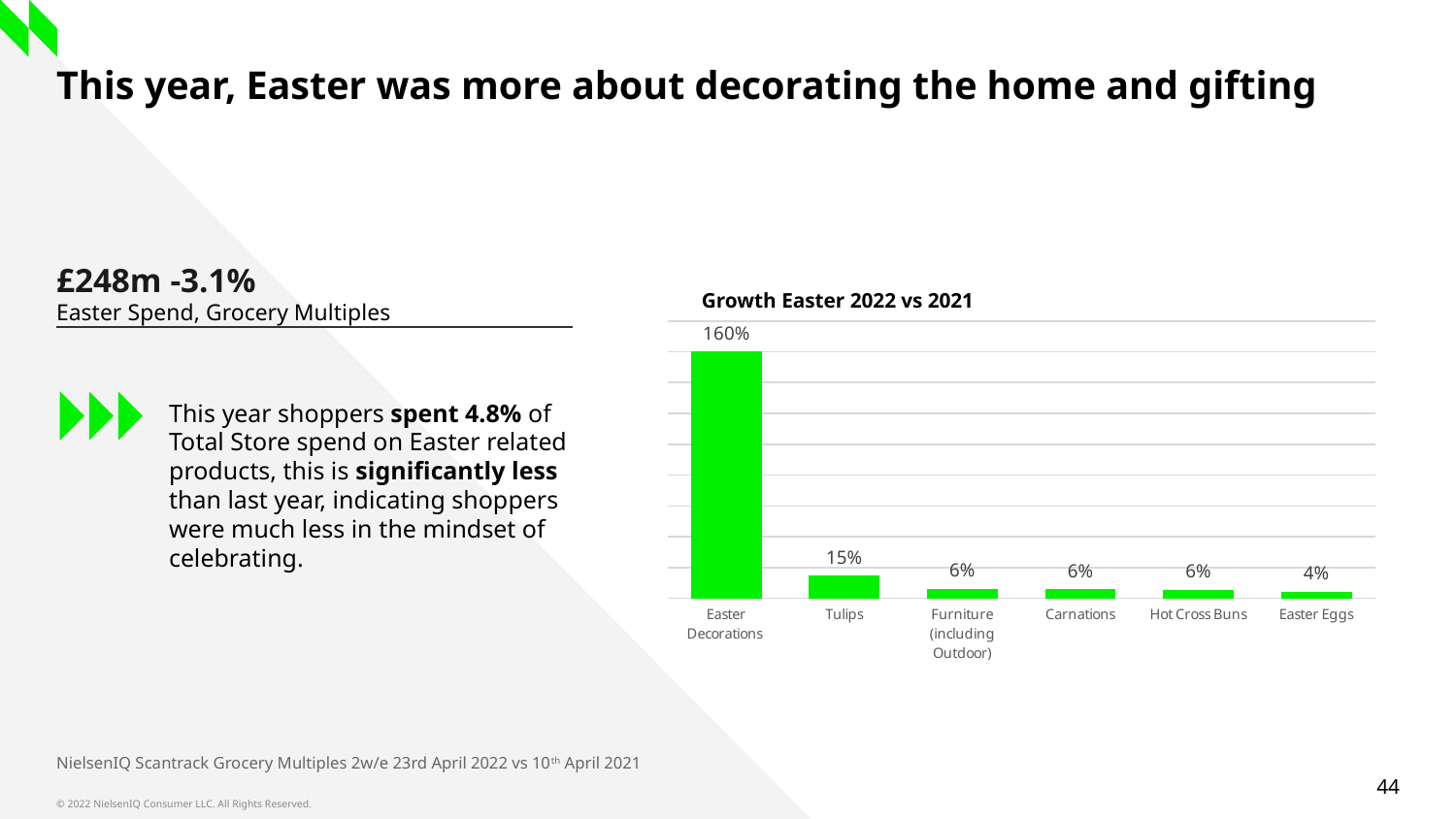
Which category has the highest growth? Easter Decorations Which has higher growth, Tulips or Carnations? Tulips What is the growth value for Easter Eggs? 4% What is the growth value for Easter Decorations? 160% What is the difference between the growth for Easter Decorations and Tulips? 145% What is the difference between the growth for Tulips and Easter Eggs? 11% What type of chart is shown on the slide? Bar chart What is the growth value for Tulips? 15% Which category has the lowest growth? Easter Eggs How many categories are shown in the chart? 6 What is the title of the chart? Growth Easter 2022 vs 2021 What is the growth value for Hot Cross Buns? 6%